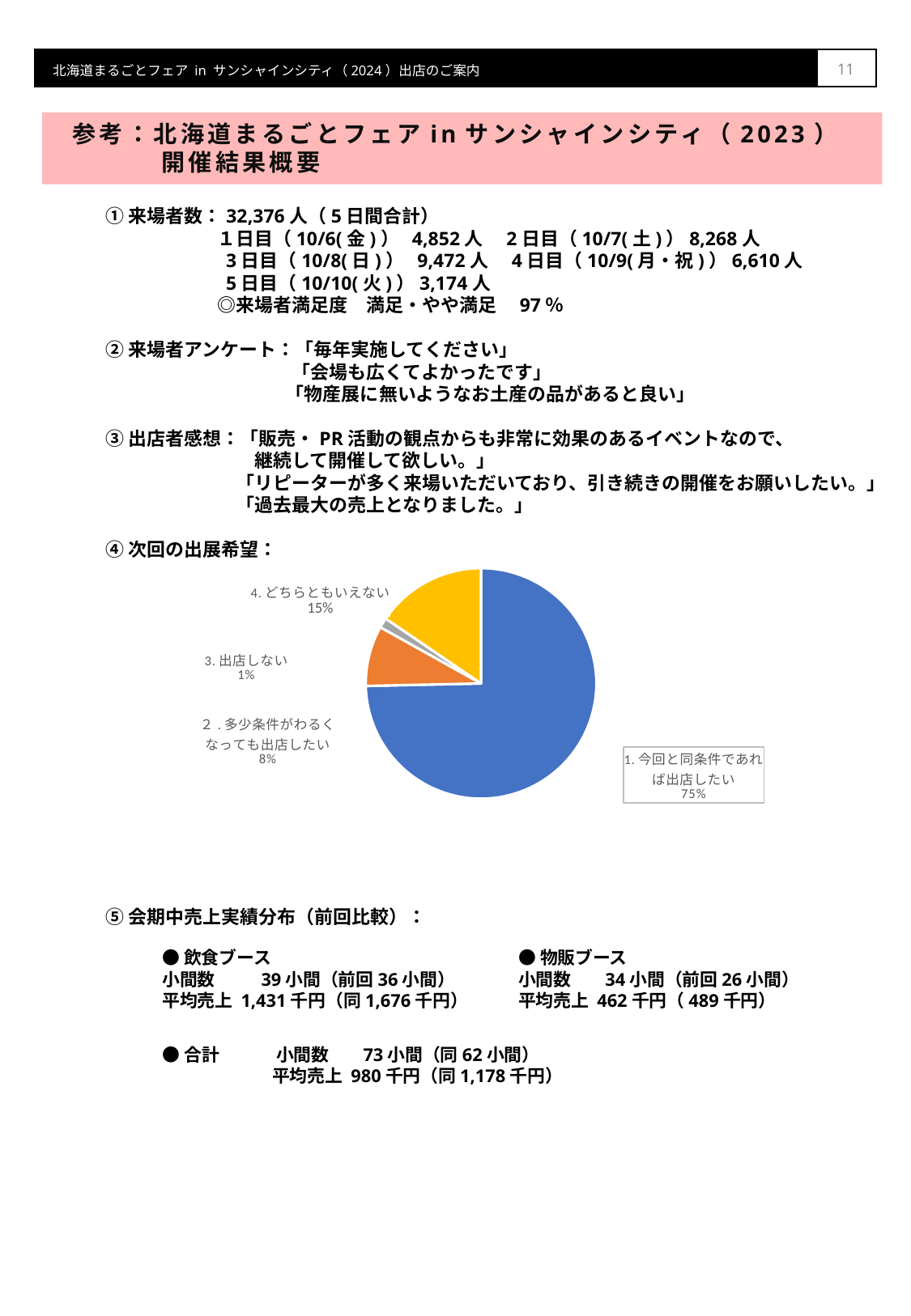
What share of the pie is labelled 1. 今回と同条件であれば出店したい? 75% Which is larger: the slice for 4. どちらともいえない or the slice for 2. 多少条件がわるくなっても出店したい? 4. どちらともいえない Which category has the largest slice of the pie? 1. 今回と同条件であれば出店したい What share of the pie is labelled 4. どちらともいえない? 15% Which category has the smallest slice of the pie? 3. 出店しない What colour is the largest slice of the pie chart? blue What is the difference in percentage points between the slice for 1. 今回と同条件であれば出店したい and the slice for 4. どちらともいえない? 60 How many slices does the pie chart have? 4 What share of the pie is labelled 3. 出店しない? 1% What colour is the slice for 4. どちらともいえない? yellow What kind of chart is shown under ④ 次回の出展希望? pie chart